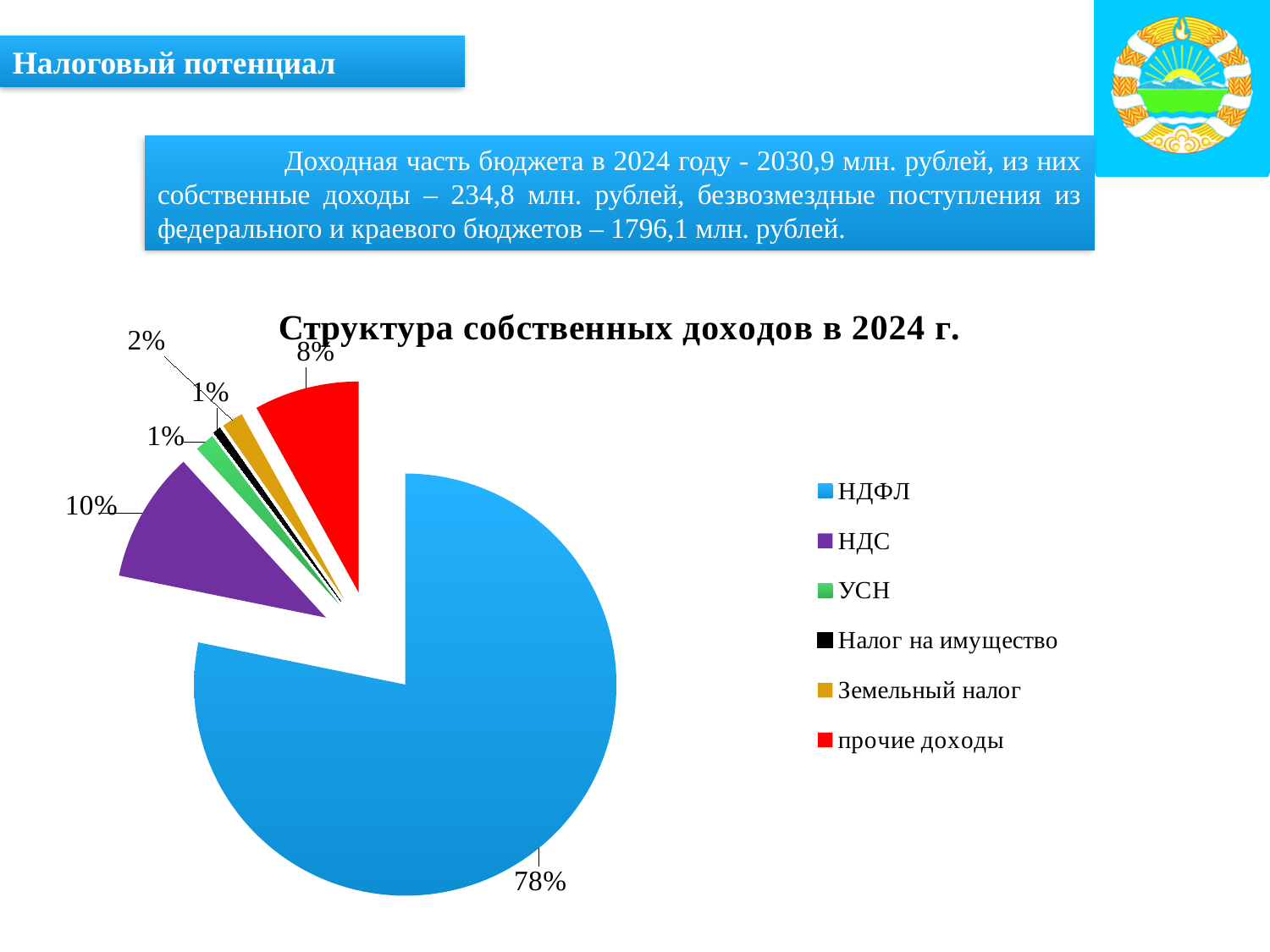
Which colour represents Налог на имущество in the legend? black What kind of chart is shown on the slide? pie chart What share of the pie does прочие доходы take? 8% What share of the pie does НДФЛ take? 78% What share of the pie does УСН take? 1% How many slices does the pie chart have? 6 Which is larger, the share for НДС or the share for прочие доходы? НДС What is the title of the chart? Структура собственных доходов в 2024 г. What is the difference between the share for НДФЛ and the share for НДС? 68% Which category has the largest share of the pie? НДФЛ